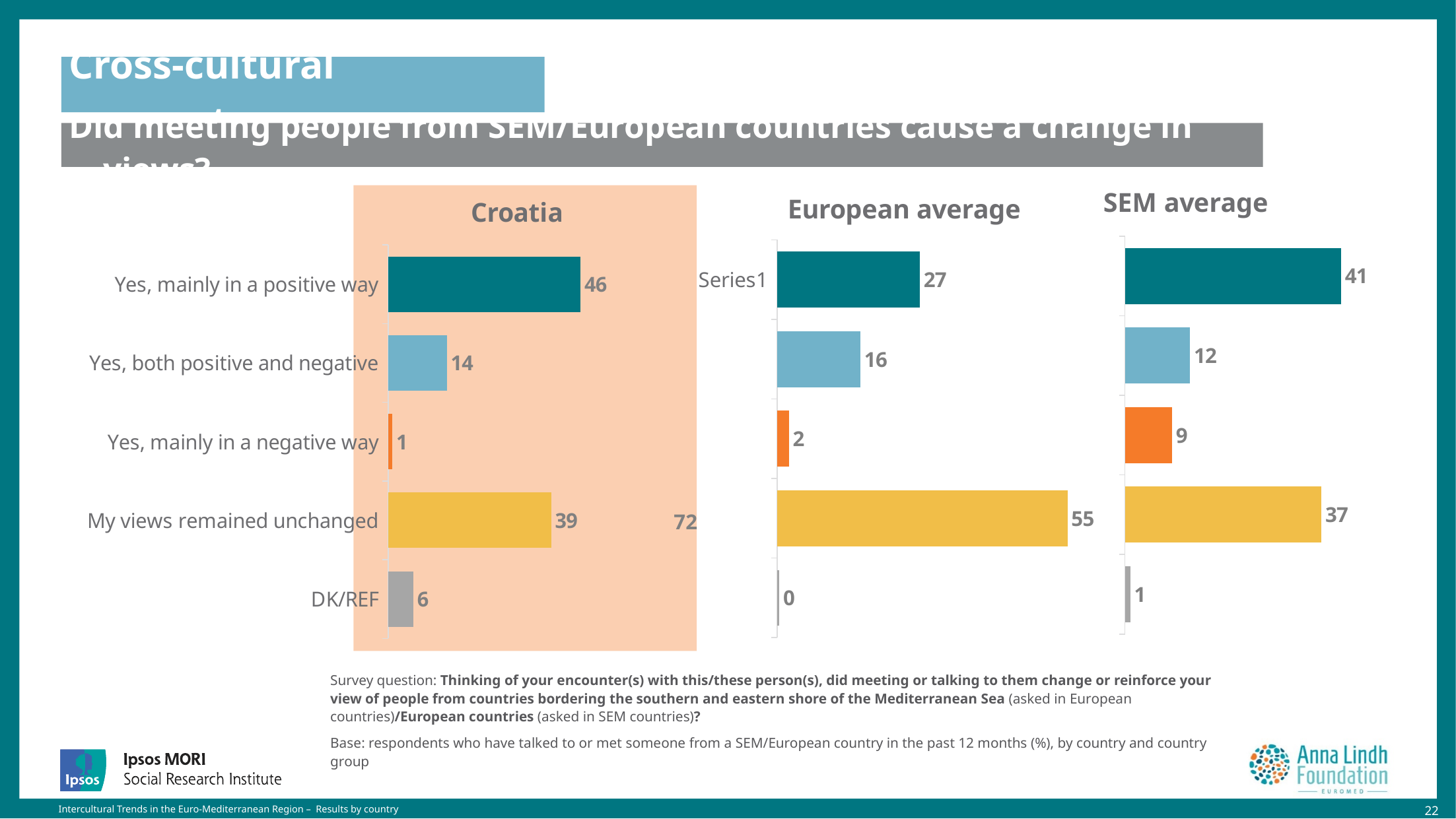
In the European average chart, what is the value for "My views remained unchanged"? 55 What type of chart is used for the Croatia data? Bar chart In the European average chart, what is the difference between "My views remained unchanged" and "Yes, mainly in a positive way"? 28 In the European average chart, which category has the lowest value? DK/REF How many categories are shown in the Croatia chart? 5 What colour are the bars for "My views remained unchanged" in the three charts? Yellow In the SEM average chart, what is the value for "Yes, mainly in a negative way"? 9 In the SEM average chart, which category has the highest value? Yes, mainly in a positive way Which is larger: "Yes, both positive and negative" in the Croatia chart or in the European average chart? European average In the Croatia chart, what is the value for "Yes, mainly in a positive way"? 46 In the Croatia chart, what is the difference between "Yes, mainly in a positive way" and "My views remained unchanged"? 7 In the Croatia chart, what is the value for DK/REF? 6